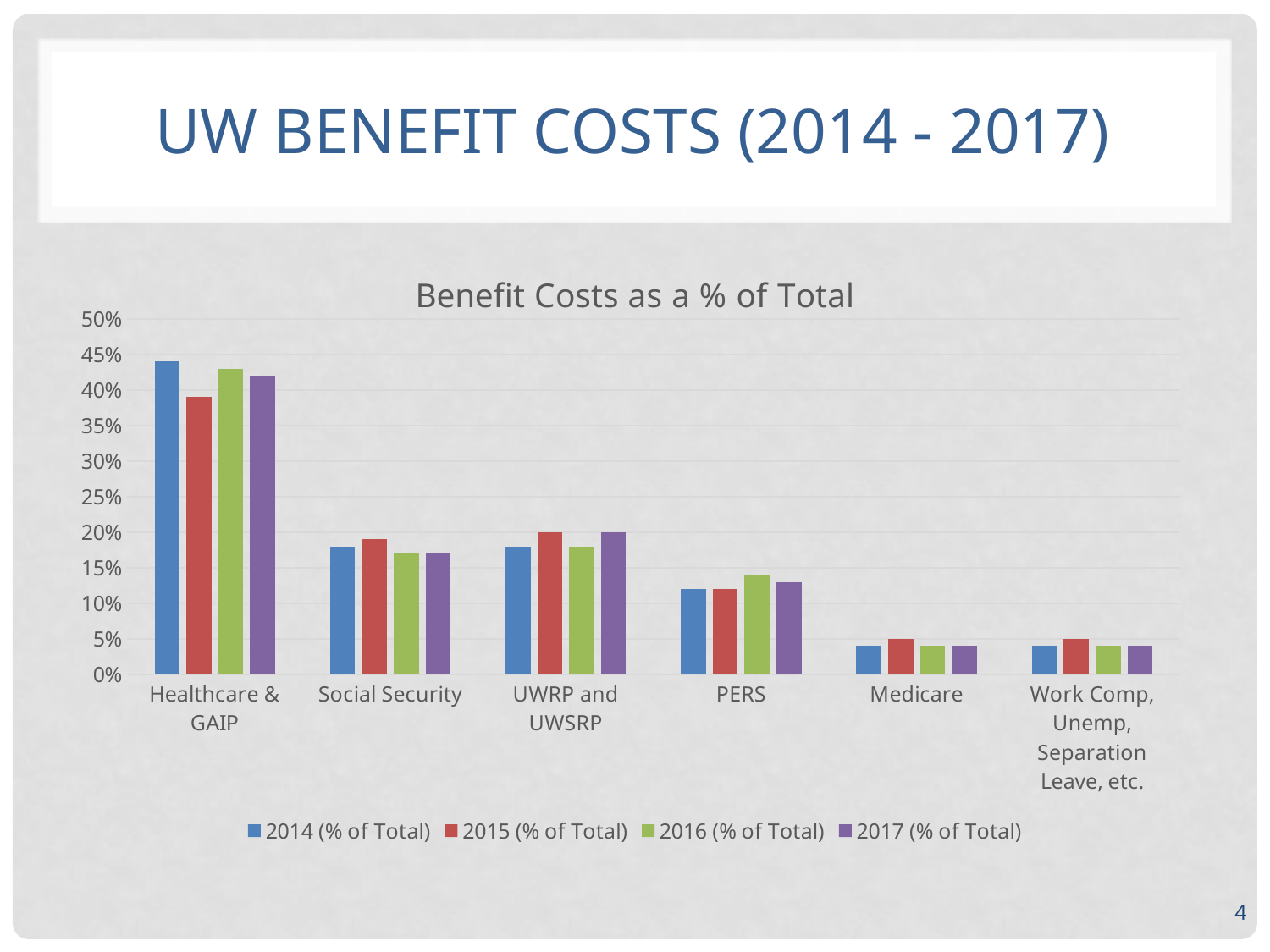
Which category has the highest value for 2014 (% of Total)? Healthcare & GAIP How many benefit categories are shown on the x axis? 6 For Healthcare & GAIP, which is larger: the 2014 (% of Total) value or the 2015 (% of Total) value? 2014 (% of Total) What kind of chart is shown on the slide? Bar chart Is the 2014 (% of Total) value for Medicare greater or less than 10%? less For 2015 (% of Total), which is larger: Social Security or PERS? Social Security Is the 2014 (% of Total) value for Social Security greater or less than 20%? less Is the 2016 (% of Total) value for PERS greater or less than 10%? greater How many series does the legend list? 4 What is the title of the chart? Benefit Costs as a % of Total